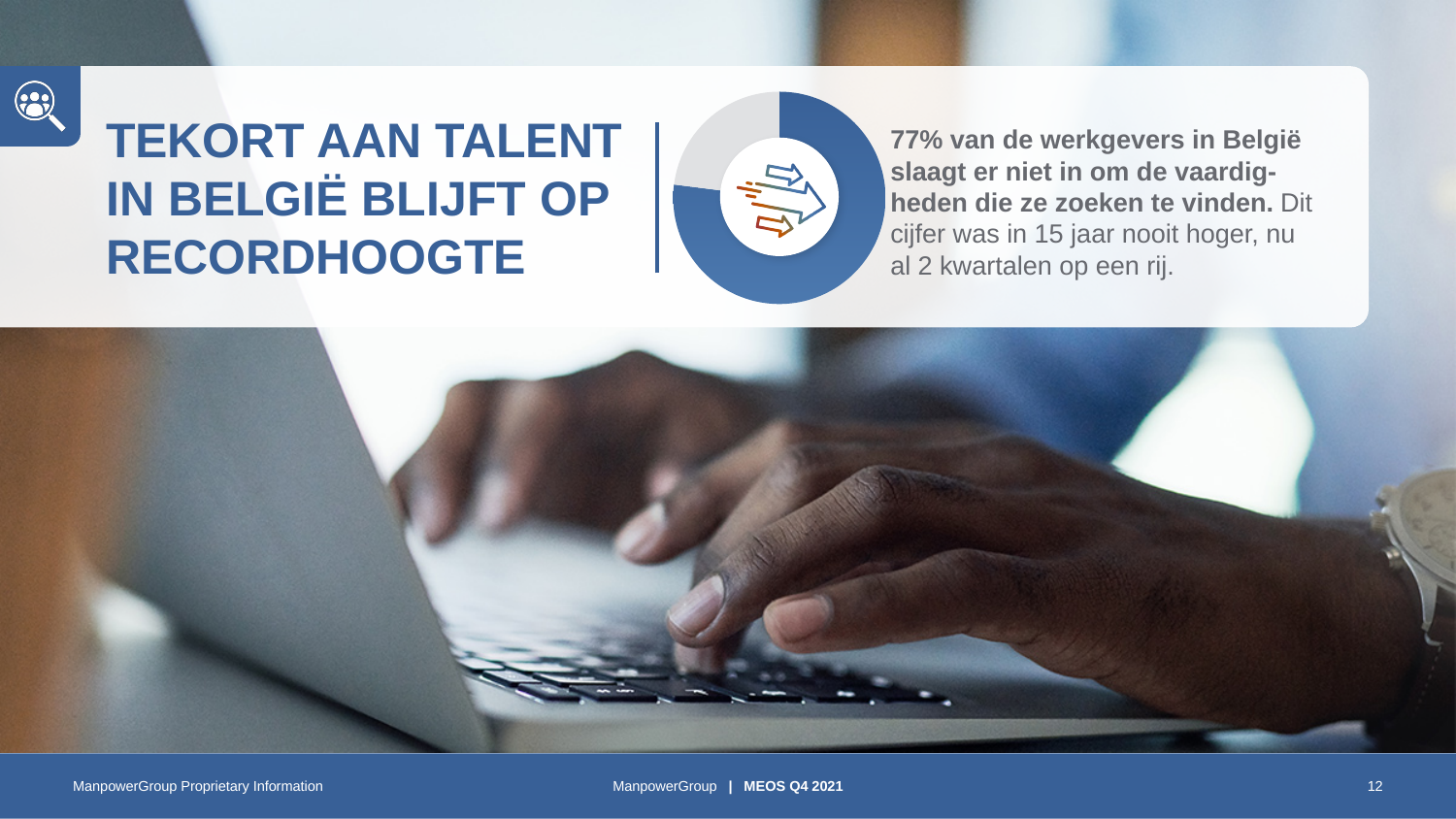
What kind of chart is shown on the slide? pie chart (donut) How many slices does the donut chart have? 2 Which slice of the donut chart is larger, the blue one or the grey one? the blue one What percentage of employers in Belgium does the slide say cannot find the skills they are looking for? 77% Is the blue slice of the donut chart greater or less than 50% of the whole? greater Is the grey slice of the donut chart greater or less than 50% of the whole? less What share of the donut chart does the blue slice represent, according to the text next to it? 77% What two colours are used for the slices of the donut chart? blue and grey